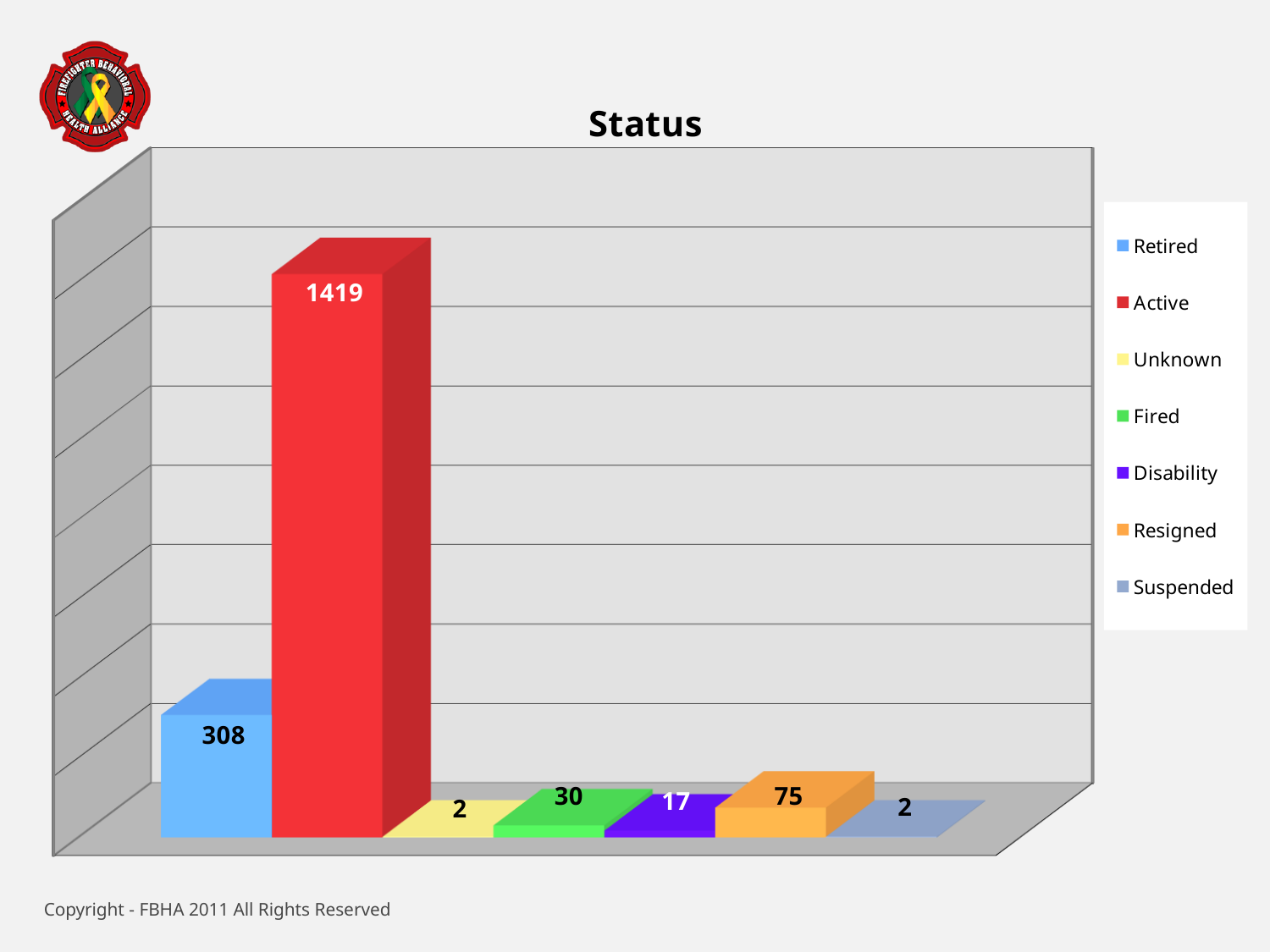
What kind of chart is shown on the slide? Bar chart Which is larger, the value for Resigned or the value for Fired? Resigned How many categories are shown in the chart? 7 What is the value for Disability? 17 What is the value for Resigned? 75 What is the value for Fired? 30 What is the value for Retired? 308 What is the value for Active? 1419 How many entries does the legend list? 7 What is the difference between the values for Active and Retired? 1111 What is the title of the chart? Status Which category has the highest value? Active